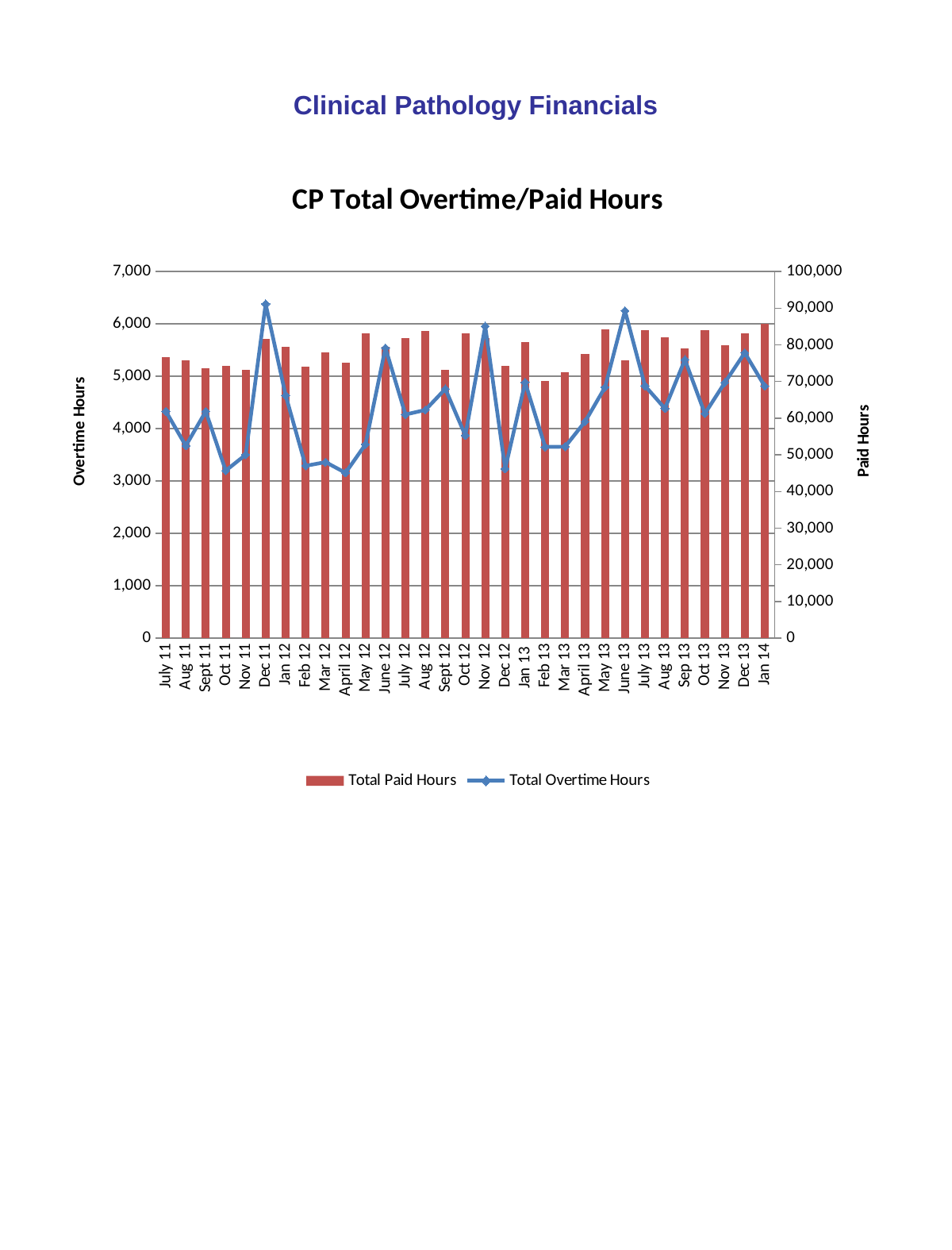
Is the Total Paid Hours value for Feb 13 greater or less than 80,000? less Is the Total Overtime Hours value for Oct 11 greater or less than 4,000? less Which month has the lowest Total Paid Hours? Feb 13 Which month has the highest Total Paid Hours? Jan 14 How many months are shown on the x axis? 31 Which month has the highest Total Overtime Hours? Dec 11 Which series is plotted as bars? Total Paid Hours What is the title of the chart? CP Total Overtime/Paid Hours What kind of chart is this? Combination bar and line chart Which month has higher Total Overtime Hours, Dec 11 or Aug 11? Dec 11 How many series does the legend list? 2 Is the Total Overtime Hours value for Dec 11 greater or less than 6,000? greater